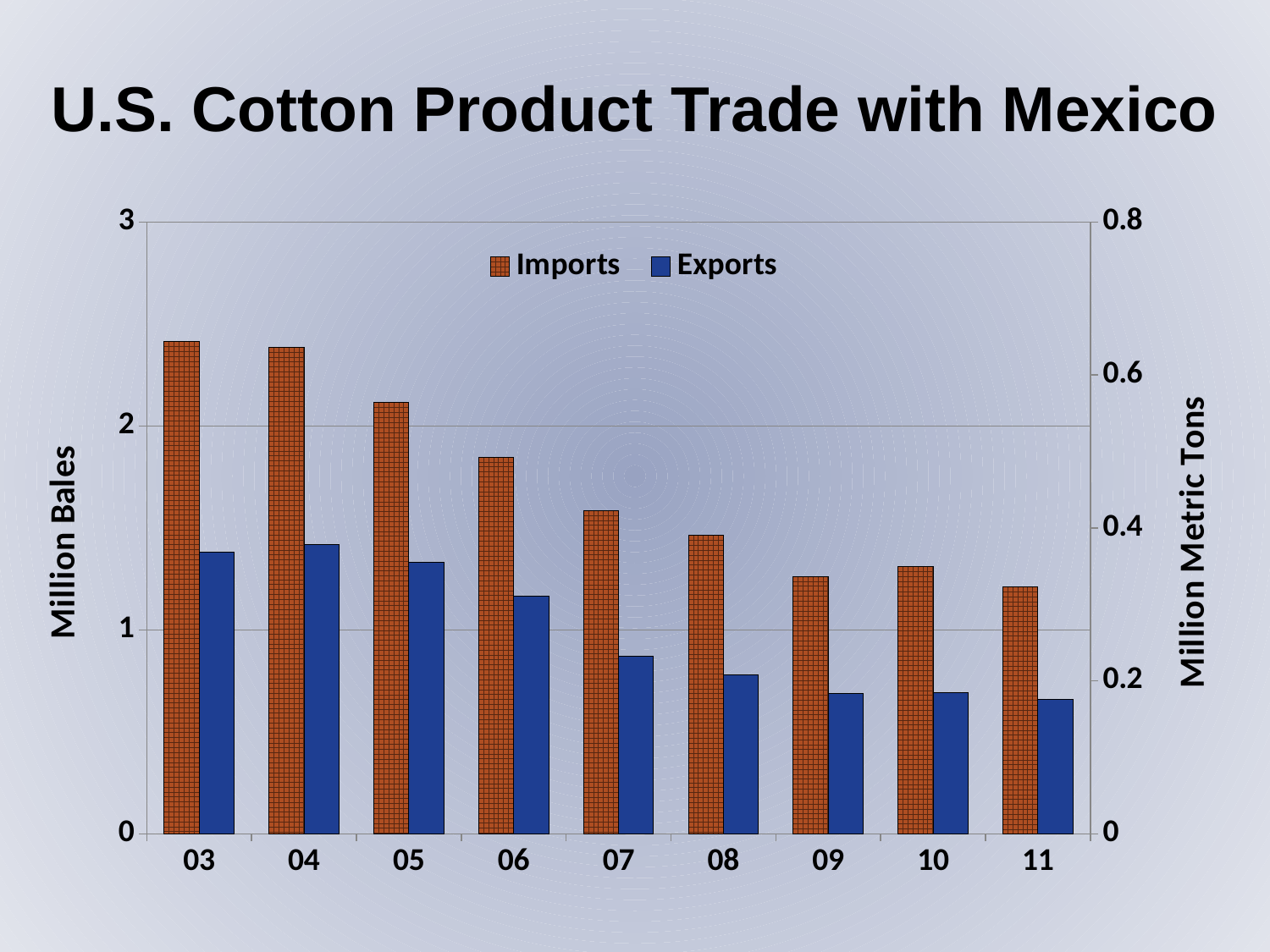
Which is larger in 03, Imports or Exports? Imports Is the Exports value for 03 greater or less than 1 million bales? greater Is the Exports value for 07 greater or less than 1 million bales? less Is the Imports value for 11 greater or less than 1 million bales? greater What is the label on the left vertical axis? Million Bales Which is larger, Imports in 05 or Imports in 08? Imports in 05 How many series does the legend list? 2 What kind of chart is shown on the slide? bar chart Do the Imports values generally rise or fall from 03 to 11? fall How many years are shown on the x axis? 9